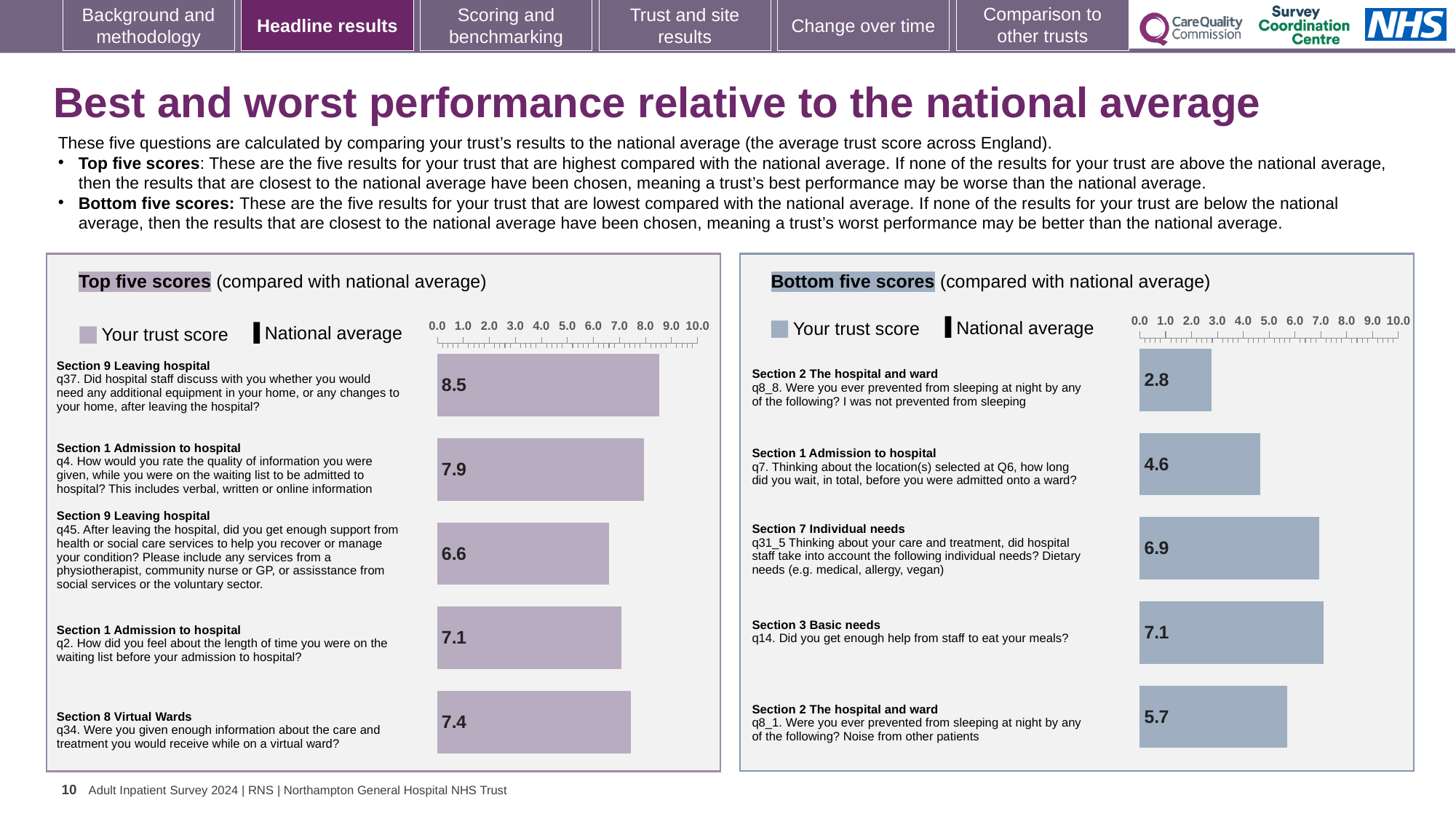
In the Bottom five scores chart, which question has the lowest trust score? q8_8 In the Top five scores chart, what is the trust score for q37 (Did hospital staff discuss with you whether you would need any additional equipment in your home)? 8.5 In the Bottom five scores chart, what is the difference between the trust scores for q14 and q8_8? 4.3 In the Top five scores chart, what is the trust score for q34 about information on care and treatment while on a virtual ward? 7.4 How many bars are plotted in the Bottom five scores chart? 5 In the Bottom five scores chart, which has the larger trust score, q7 or q8_1? q8_1 In the Top five scores chart, which question has the lowest trust score? q45 In the Bottom five scores chart, what is the trust score for q8_8 (I was not prevented from sleeping)? 2.8 What type of chart is the Top five scores chart? Bar chart In the Top five scores chart, what is the difference between the trust scores for q37 and q4? 0.6 In the Top five scores chart, which question has the highest trust score? q37 In the Bottom five scores chart, what is the trust score for q14 (Did you get enough help from staff to eat your meals)? 7.1